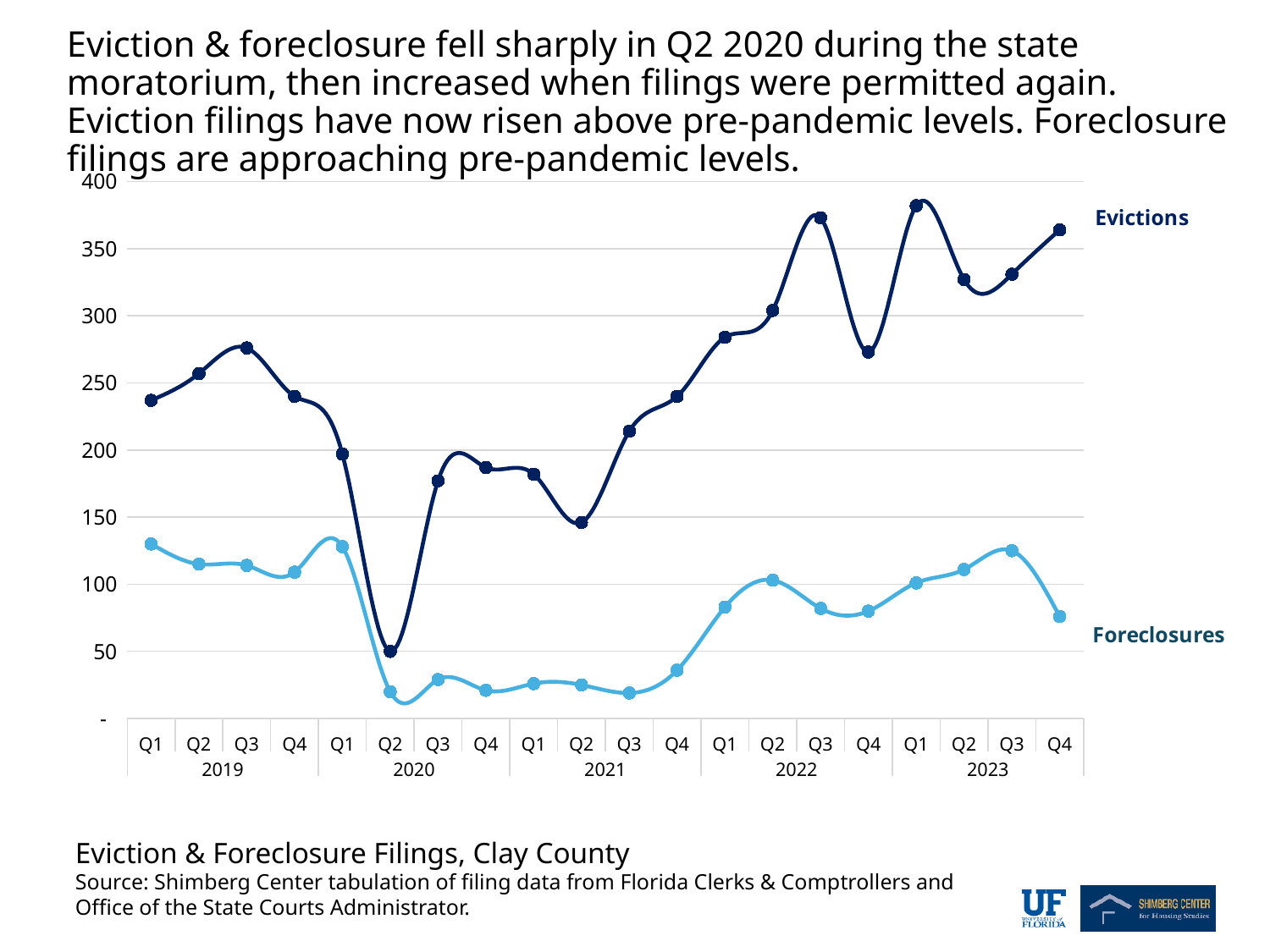
Is the Evictions value for Q2 2020 greater or less than 100? less Which series is drawn with the darker navy line? Evictions What is the title of the chart? Eviction & Foreclosure Filings, Clay County Is the Evictions value for Q1 2023 greater or less than 350? greater How many quarterly data points does each series have on the chart? 20 Is the Foreclosures value for Q4 2023 greater or less than 100? less What kind of chart is shown on the slide? Line chart Which is higher for Evictions: Q1 2019 or Q3 2019? Q3 2019 Do Evictions rise or fall from Q3 2019 to Q2 2020? Fall In which quarter is the Evictions series at its lowest? Q2 2020 How many series are plotted on the chart? 2